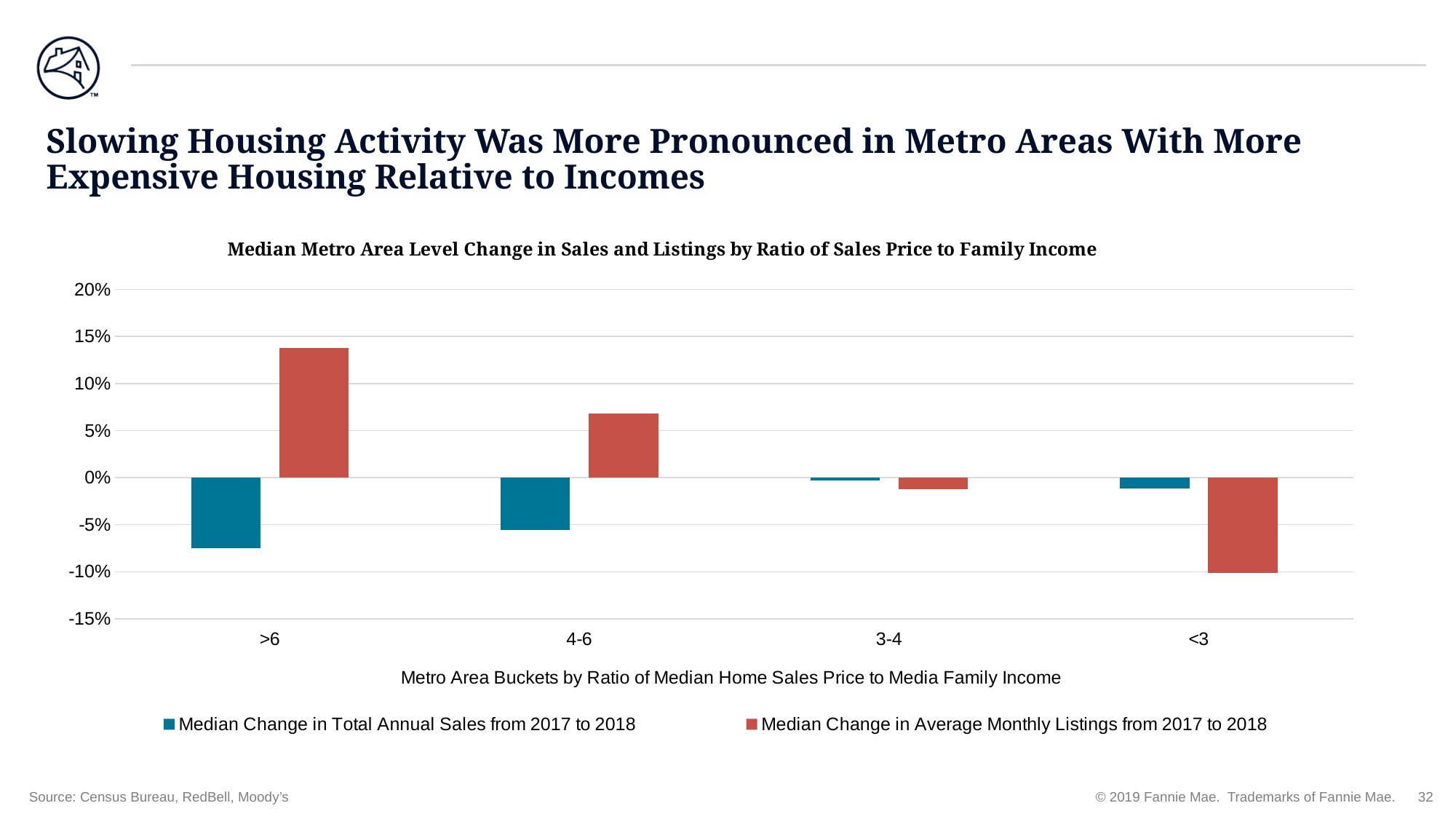
How many metro area buckets are shown on the x axis? 4 Which bucket has a larger Median Change in Average Monthly Listings, >6 or 4-6? >6 Is the Median Change in Average Monthly Listings for the 4-6 bucket greater or less than 5%? greater What kind of chart is shown on the slide? Bar chart Is the Median Change in Average Monthly Listings for the >6 bucket greater or less than 10%? greater Which bucket has the lowest Median Change in Total Annual Sales from 2017 to 2018? >6 What is the title of the chart? Median Metro Area Level Change in Sales and Listings by Ratio of Sales Price to Family Income Is the Median Change in Average Monthly Listings for the <3 bucket greater or less than -5%? less How many series does the legend list? 2 Which bucket has the lowest Median Change in Average Monthly Listings from 2017 to 2018? <3 Which bucket has the highest Median Change in Average Monthly Listings from 2017 to 2018? >6